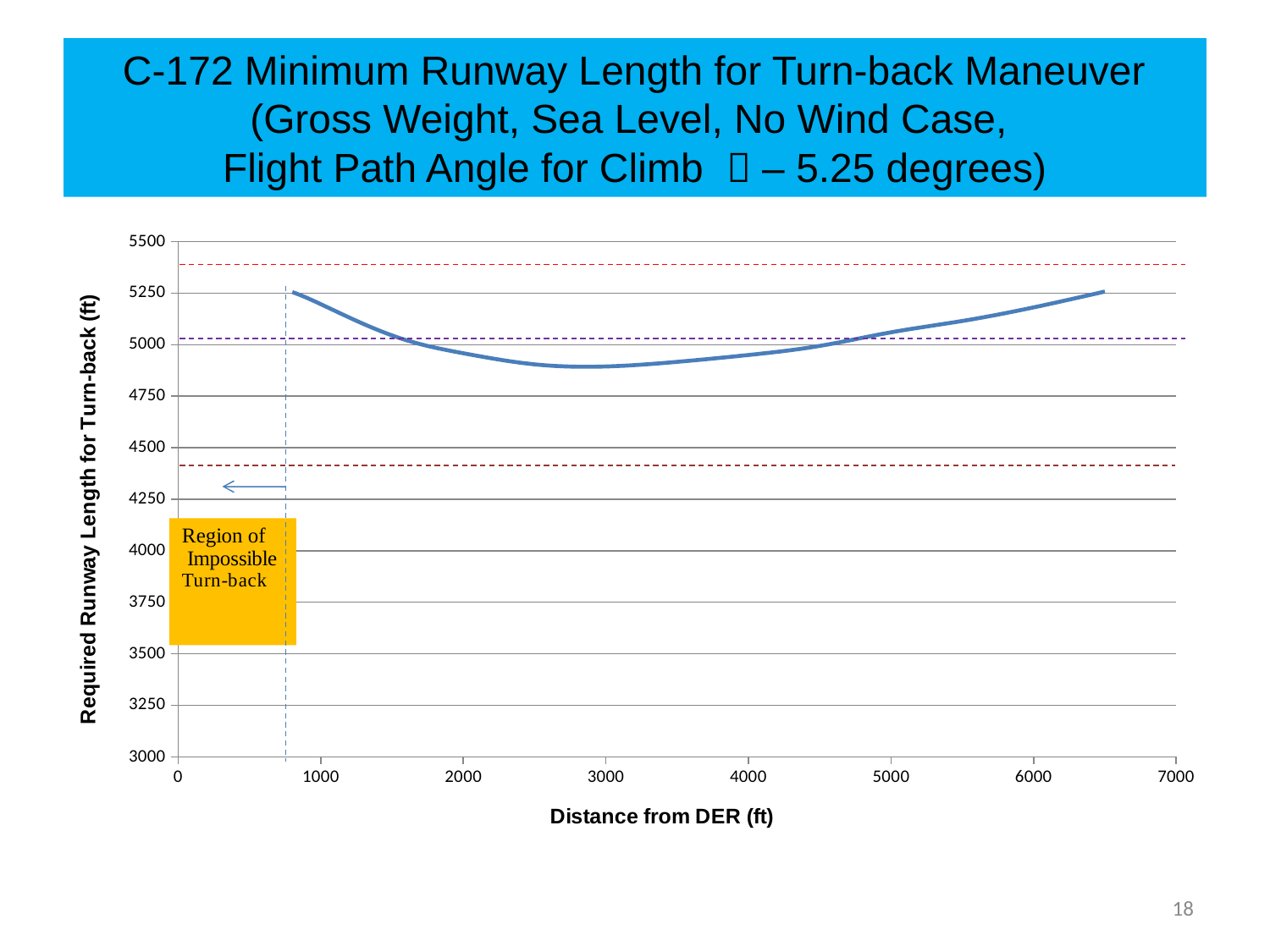
Which has the larger required runway length: the curve at 2000 ft or at 3000 ft from DER? 2000 ft What is the title of the x axis? Distance from DER (ft) What kind of chart is shown on the slide? line chart Does the curve rise or fall as the distance from DER increases from 1000 ft to 3000 ft? fall Does the curve rise or fall as the distance from DER increases from 4000 ft to 6000 ft? rise Which has the larger required runway length: the curve at 5000 ft or at 6000 ft from DER? 6000 ft Is the value of the curve at a distance of 3000 ft from DER greater or less than 5000? less Is the highest point of the curve greater or less than 5500? less Is the value of the curve at a distance of 1000 ft from DER greater or less than 5000? greater What is the title of the y axis? Required Runway Length for Turn-back (ft)